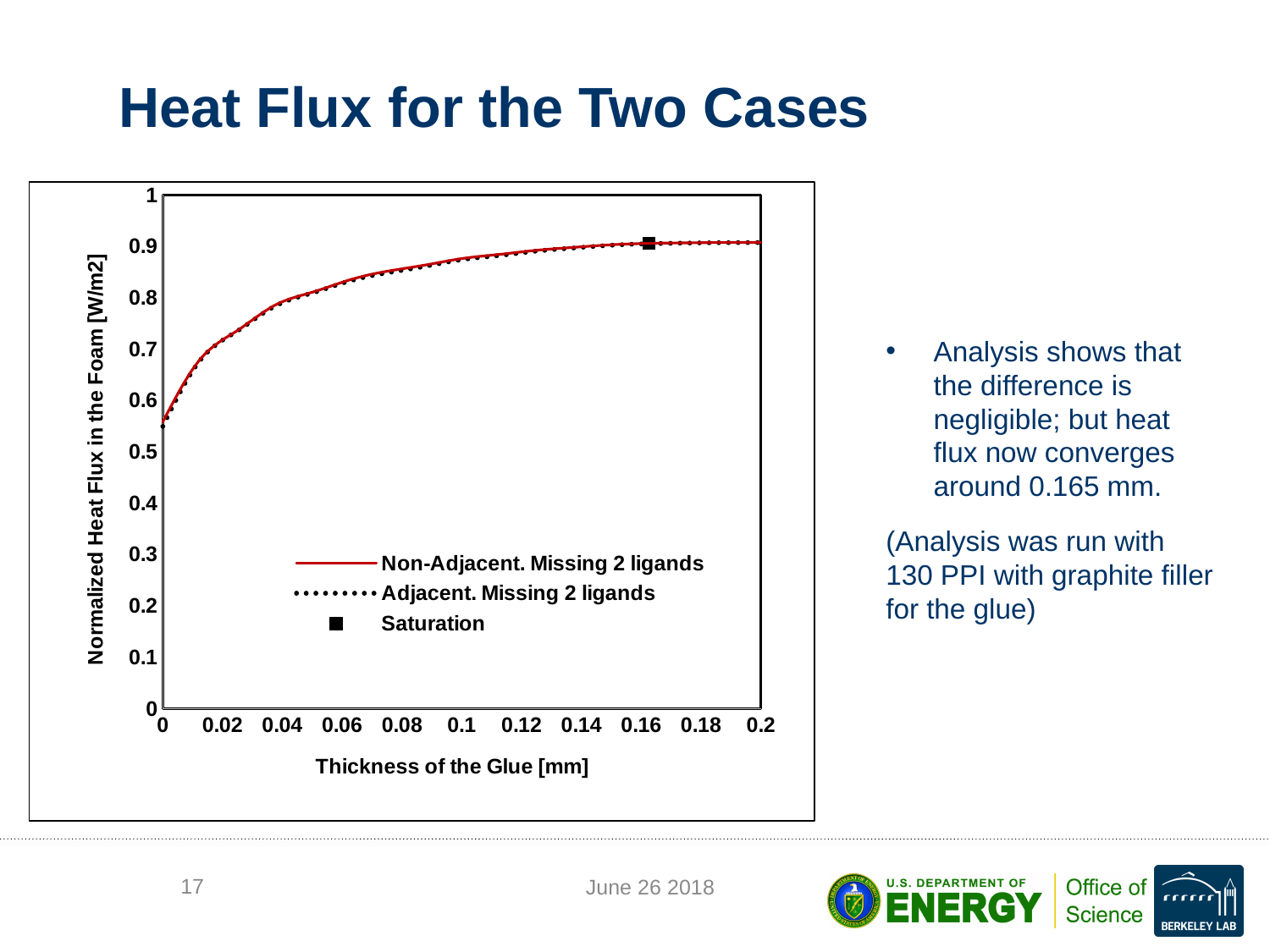
Is the value of the Non-Adjacent. Missing 2 ligands series at a glue thickness of 0 mm greater or less than 0.5? greater What kind of chart is shown on the slide? line chart Is the value of the Non-Adjacent. Missing 2 ligands series at a glue thickness of 0.02 mm greater or less than 0.8? less Is the value of the Non-Adjacent. Missing 2 ligands series at a glue thickness of 0.2 mm greater or less than 0.8? greater What colour is the line for the Non-Adjacent. Missing 2 ligands series? red Does the normalized heat flux rise or fall as the thickness of the glue increases? rises How many entries does the chart legend list? 3 What is the title of the x axis of the chart? Thickness of the Glue [mm] What is the highest tick value shown on the x axis? 0.2